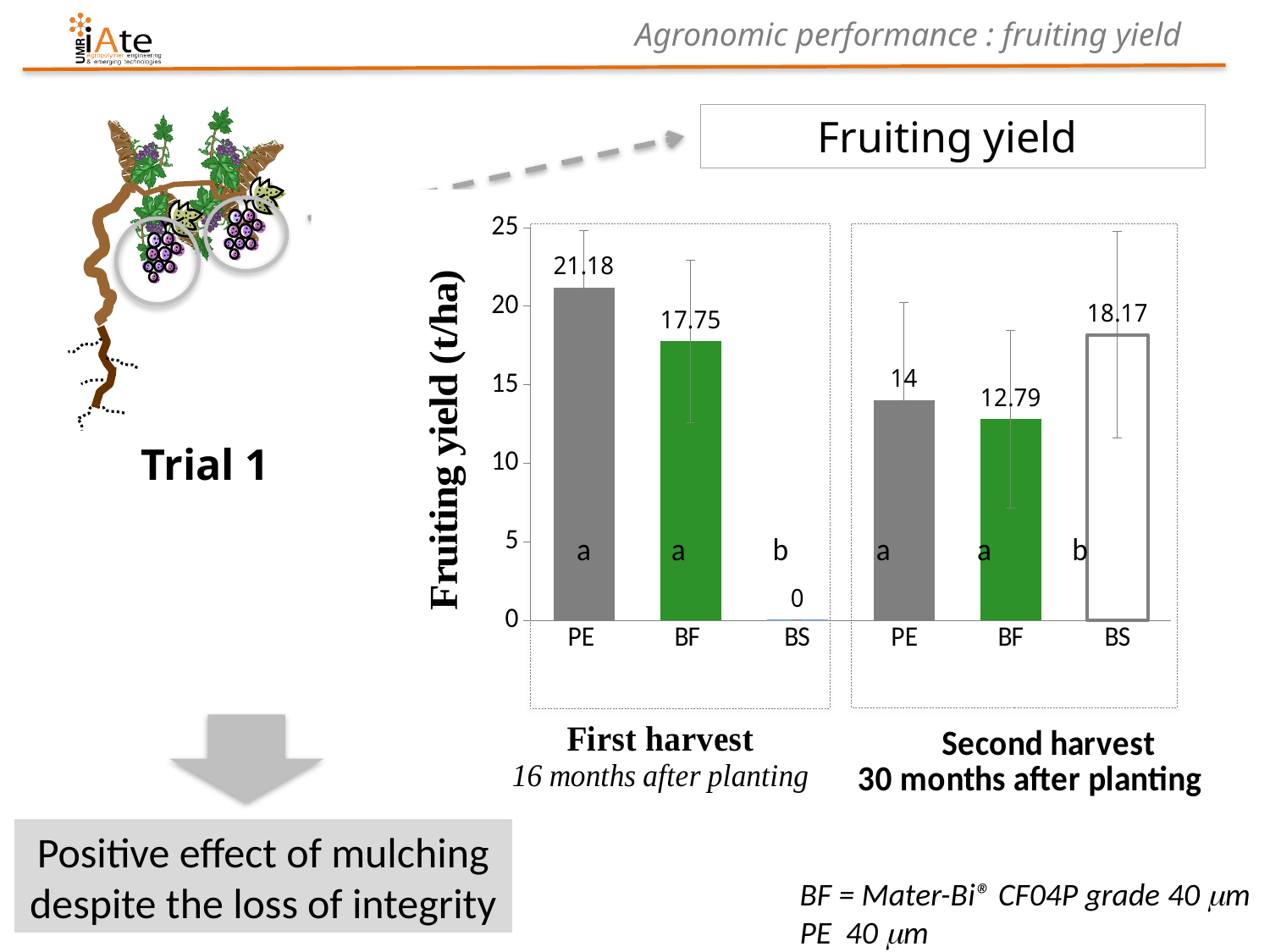
What type of chart is shown on the slide? Bar chart What is the difference in fruiting yield between BS and PE in the second harvest? 4.17 What is the difference in fruiting yield between PE and BF in the first harvest? 3.43 What is the fruiting yield for BS in the first harvest? 0 Which treatment has the lowest fruiting yield in the second harvest? BF Is the fruiting yield for BF in the first harvest greater or less than 15? greater Which treatment has the highest fruiting yield in the first harvest? PE What is the fruiting yield for PE in the first harvest? 21.18 What is the fruiting yield for BS in the second harvest? 18.17 What is the fruiting yield for BF in the second harvest? 12.79 How many bars are plotted in the chart in total? 6 Which has a larger fruiting yield in the second harvest, PE or BS? BS